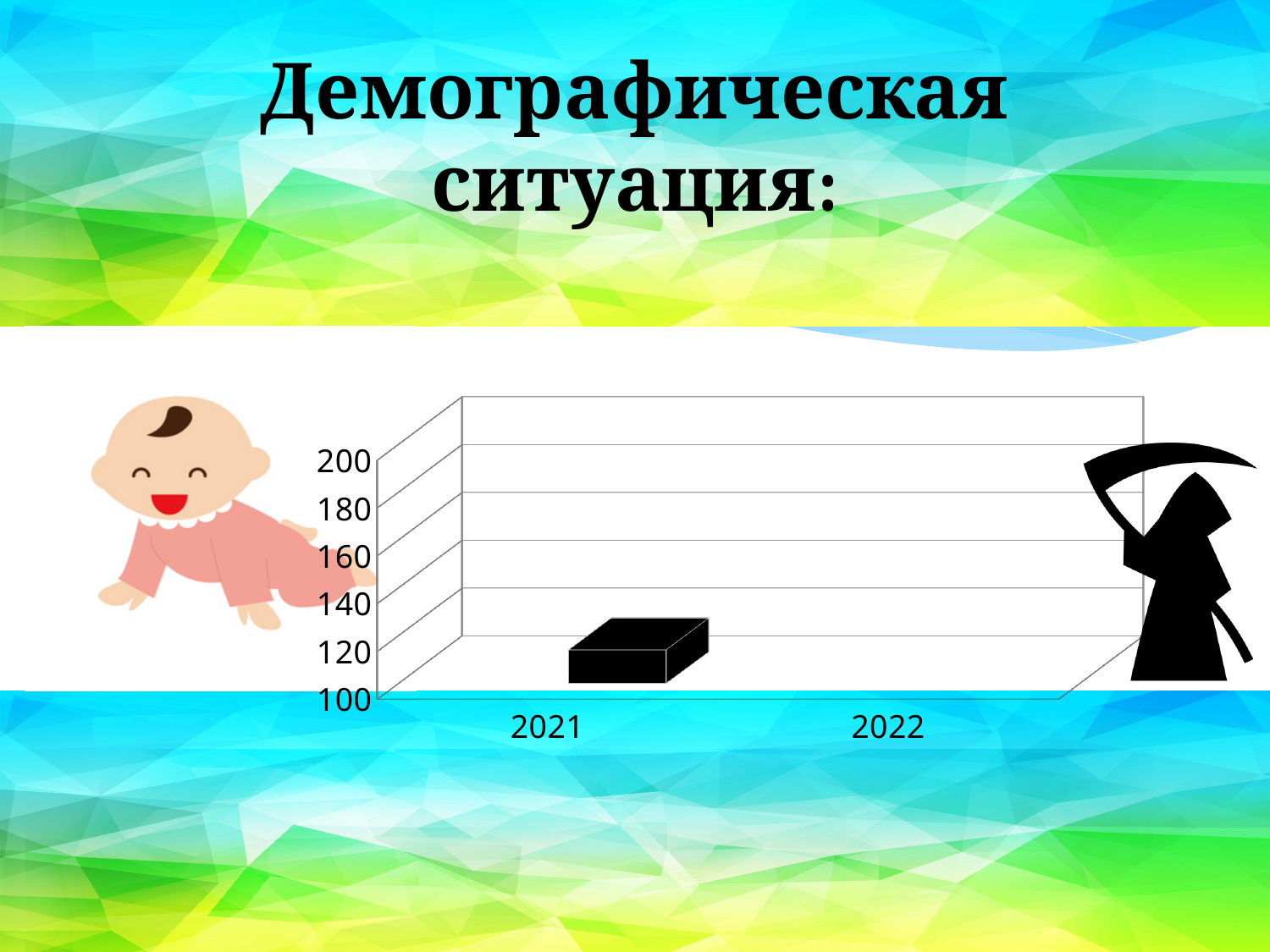
What kind of chart is shown on the slide? bar chart Which years are labelled on the x axis of the chart? 2021 and 2022 What is the lowest value shown on the y axis of the chart? 100 What is the highest value shown on the y axis of the chart? 200 How many categories are shown on the x axis of the chart? 2 Is the value for 2021 greater or less than 140? less